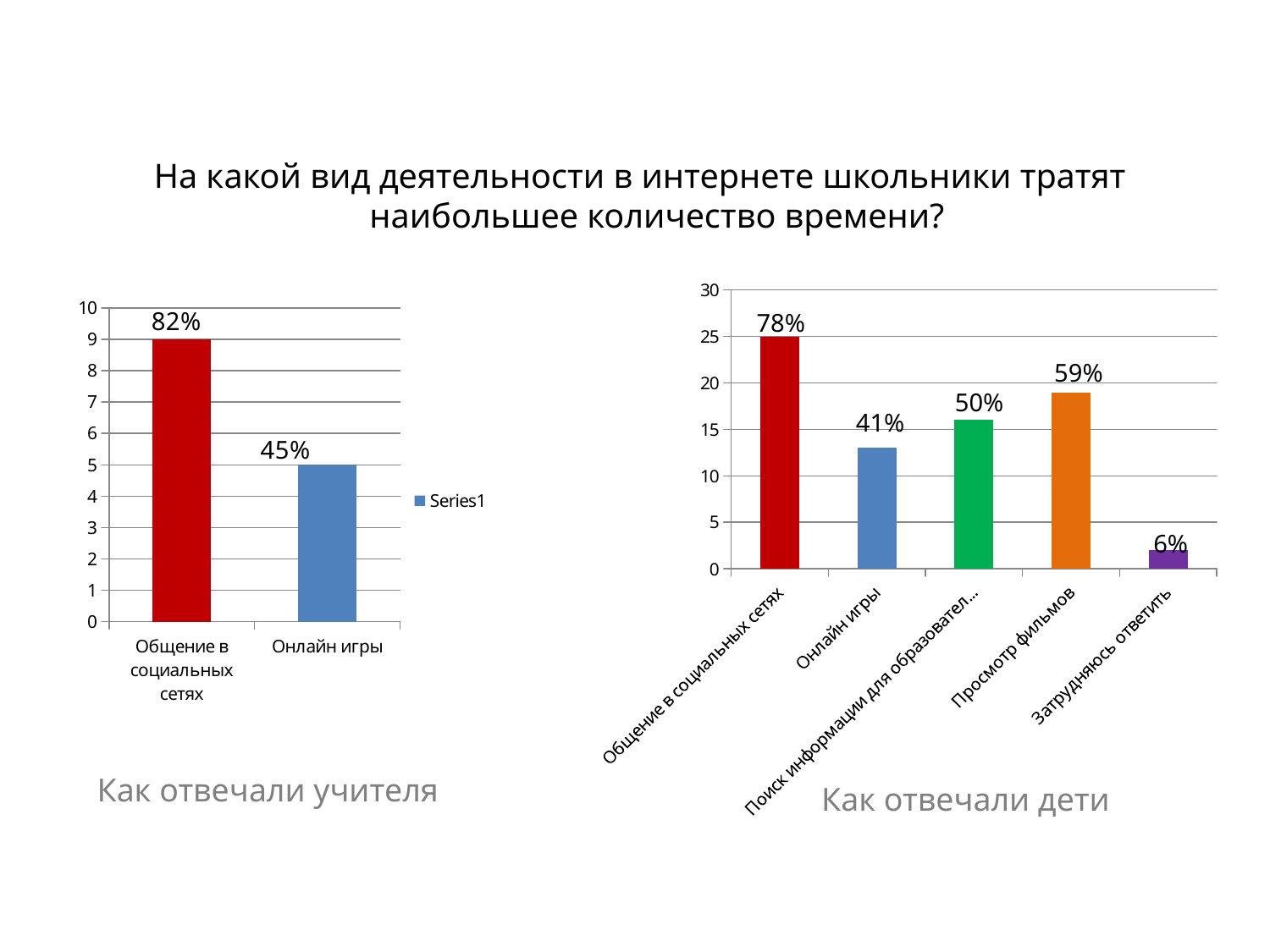
How many categories are shown in the right chart (Как отвечали дети)? 5 What legend entry is shown next to the left chart (Как отвечали учителя)? Series1 In the left chart (Как отвечали учителя), which bar is taller: Общение в социальных сетях or Онлайн игры? Общение в социальных сетях In the right chart (Как отвечали дети), which category has the highest bar? Общение в социальных сетях In the left chart (Как отвечали учителя), what is the data label on the bar for Общение в социальных сетях? 82% What type of chart is the left chart (Как отвечали учителя)? bar chart In the right chart (Как отвечали дети), what is the data label on the bar for Затрудняюсь ответить? 6% In the left chart (Как отвечали учителя), what is the data label on the bar for Онлайн игры? 45% In the right chart (Как отвечали дети), is the bar for Онлайн игры greater or less than 10 on the vertical axis? greater In the right chart (Как отвечали дети), which category has the lowest bar? Затрудняюсь ответить In the right chart (Как отвечали дети), what is the difference between the data labels for Просмотр фильмов and Онлайн игры? 18% In the right chart (Как отвечали дети), what is the data label on the bar for Просмотр фильмов? 59%